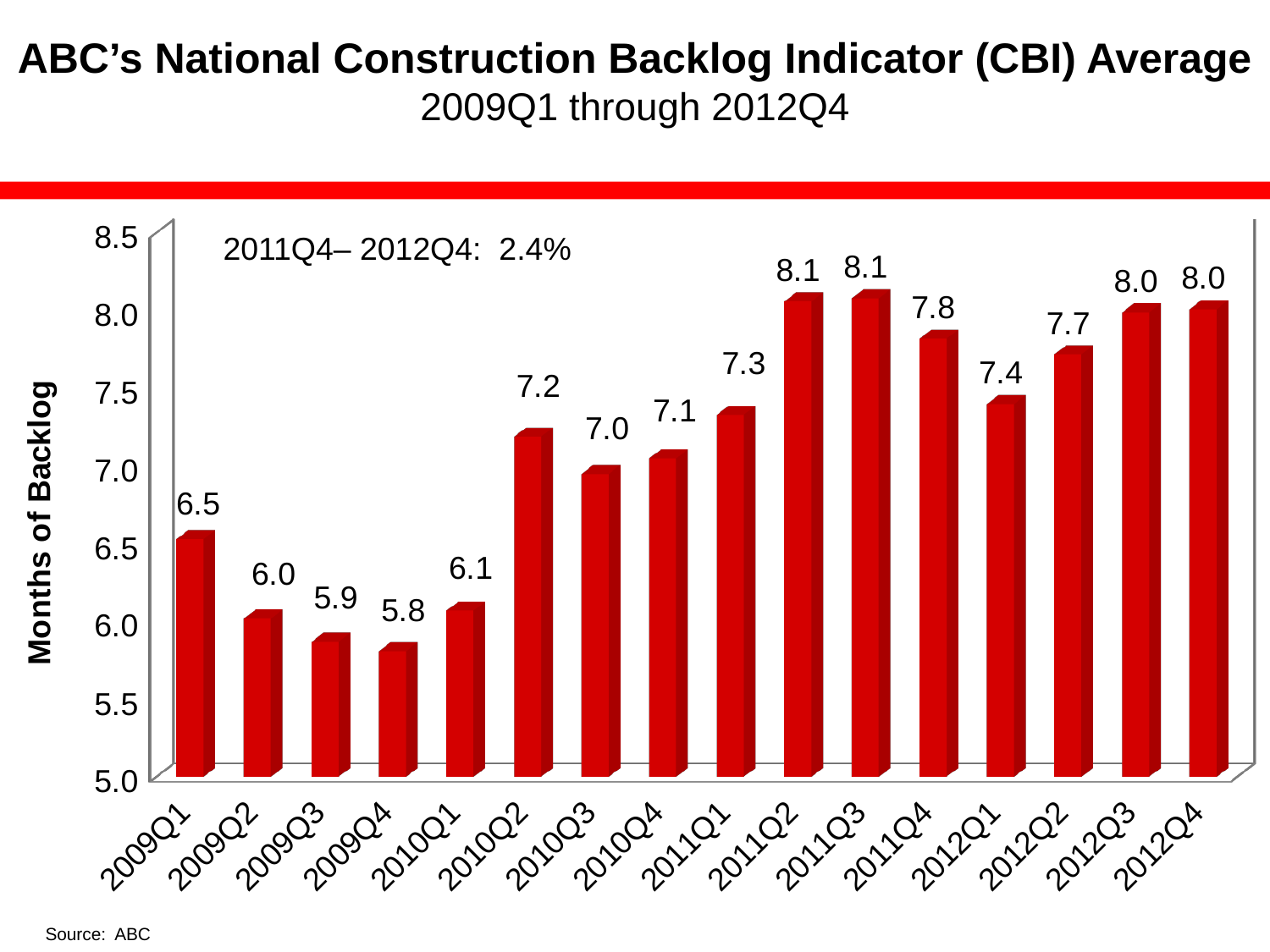
What kind of chart is shown on the slide? Bar chart What is the months of backlog value for 2011Q4? 7.8 What is the months of backlog value for 2012Q4? 8.0 What is the highest months of backlog value shown on the chart? 8.1 Do the values rise or fall from 2009Q1 to 2009Q4? Fall What is the difference in months of backlog between 2012Q4 and 2011Q4? 0.2 What is the months of backlog value for 2009Q1? 6.5 How many quarters are shown on the chart? 16 Which quarter has the lowest months of backlog? 2009Q4 What is the difference in months of backlog between 2010Q2 and 2010Q1? 1.1 Which is larger, the value for 2012Q1 or the value for 2011Q4? 2011Q4 What is the y-axis label of the chart? Months of Backlog